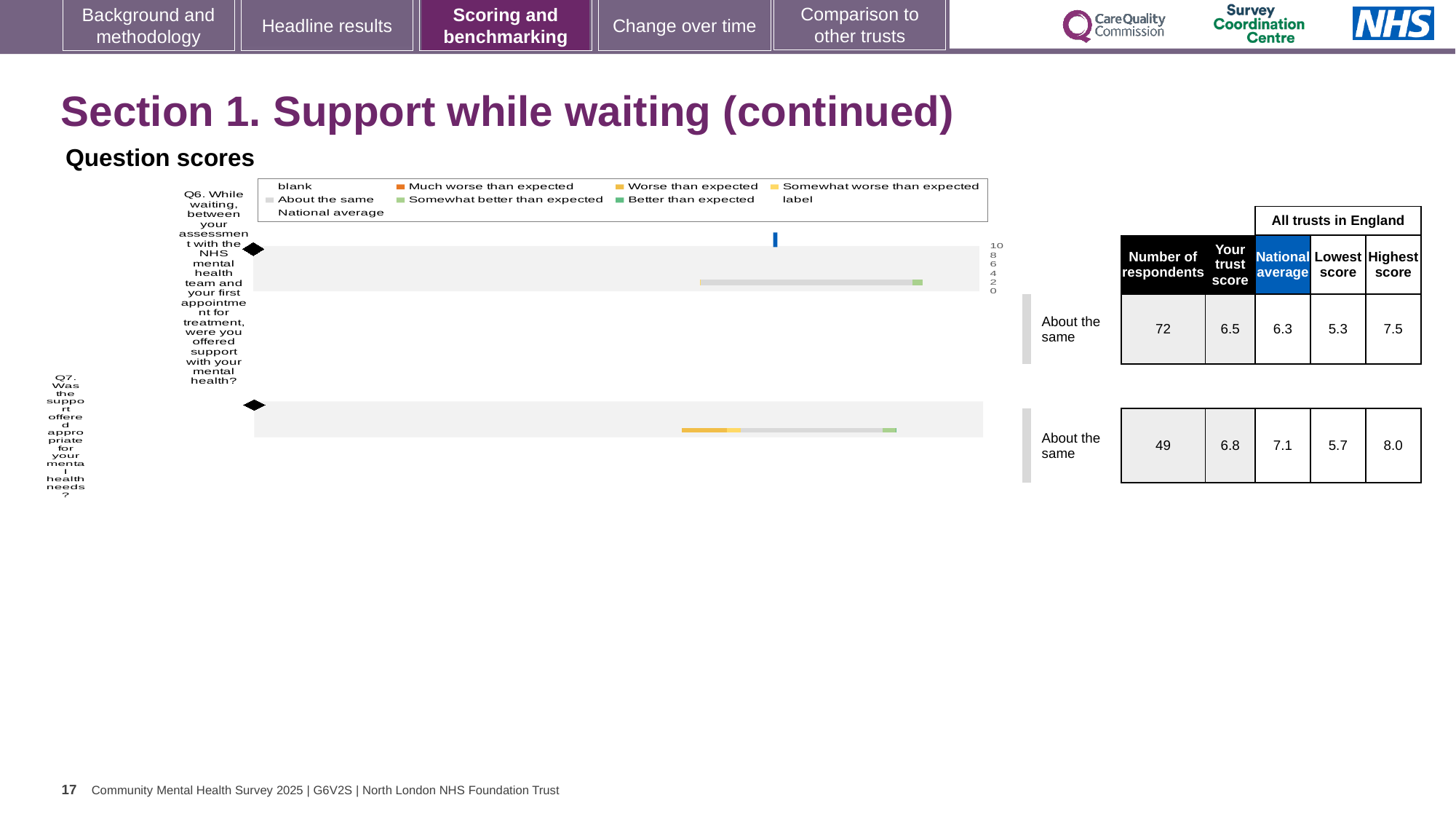
What benchmark category is shown for Q6? About the same For Q6, what is the national average score shown next to the chart? 6.3 For Q6, what is the difference between the highest score and the lowest score across all trusts in England? 2.2 For Q6, how many respondents are shown in the table next to the chart? 72 How many questions (bars) are plotted on the slide? 2 For Q7, which is larger: your trust score or the national average? national average What kind of chart is used to show the Q6 and Q7 question scores? bar chart What is the highest value shown on the score axis of the charts? 10 For Q7, what is the difference between the highest score and the lowest score across all trusts in England? 2.3 Which question has more respondents, Q6 or Q7? Q6 For Q7, what is 'Your trust score' shown next to the chart? 6.8 What colour does the legend use for 'Better than expected'? green